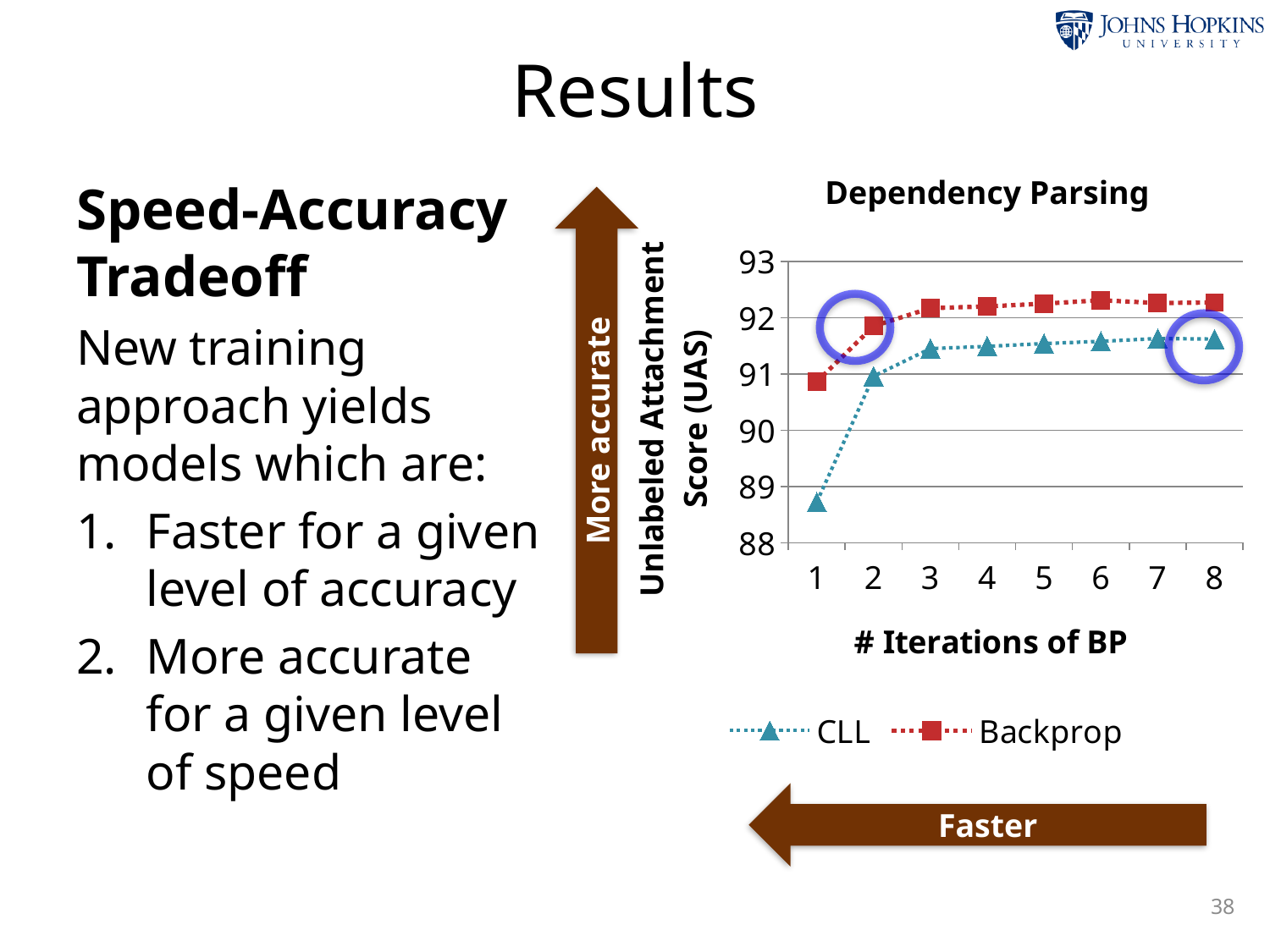
Is the Backprop value at 8 iterations of BP greater or less than 92? greater At which number of iterations of BP is the CLL series lowest? 1 Does the CLL series rise or fall as the number of iterations of BP increases? rise How many iteration values are plotted along the x axis of the Dependency Parsing chart? 8 Which series in the Dependency Parsing chart has the higher UAS at 1 iteration of BP, CLL or Backprop? Backprop What kind of chart is shown under the title "Dependency Parsing"? line chart How many series does the legend of the Dependency Parsing chart list? 2 What is the label of the y axis in the Dependency Parsing chart? Unlabeled Attachment Score (UAS) At which number of iterations of BP is the Backprop series lowest? 1 Is the CLL value at 1 iteration of BP greater or less than 89? less Is the CLL value at 3 iterations of BP greater or less than 91? greater